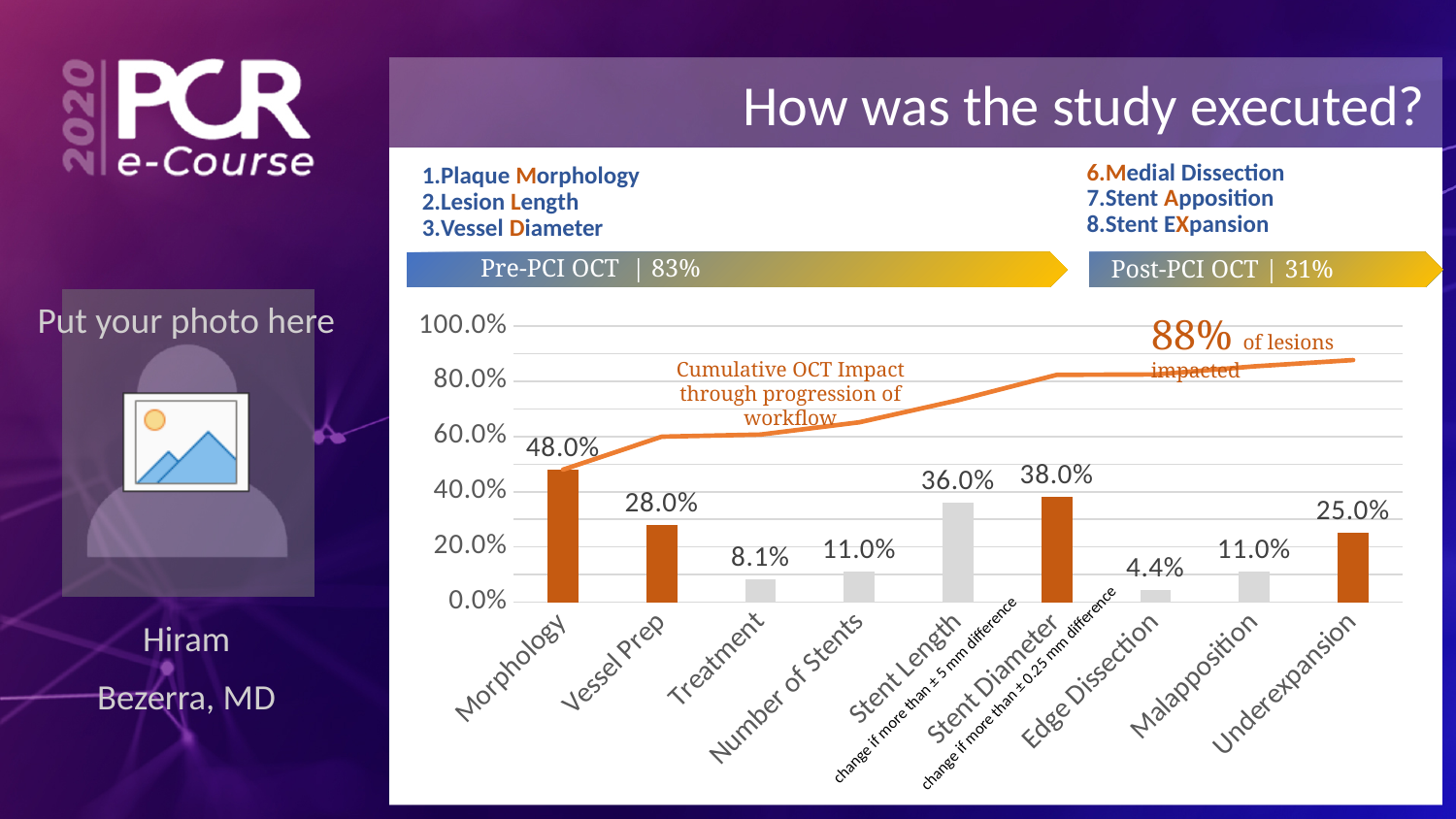
What is the value for Edge Dissection? 4.4% What is the value for Vessel Prep? 28.0% What is the difference between the values for Stent Diameter and Stent Length? 2.0% What is the value for Morphology? 48.0% What kind of chart is shown on the slide? combination bar and line chart How many categories are shown on the x axis of the bar chart? 9 Which category has the lowest bar? Edge Dissection Is the value for Treatment greater or less than 20.0%? less What percentage of lesions impacted does the cumulative OCT impact line reach at its end? 88% Which is larger, the value for Vessel Prep or the value for Underexpansion? Vessel Prep Which category has the highest bar? Morphology What is the value for Underexpansion? 25.0%